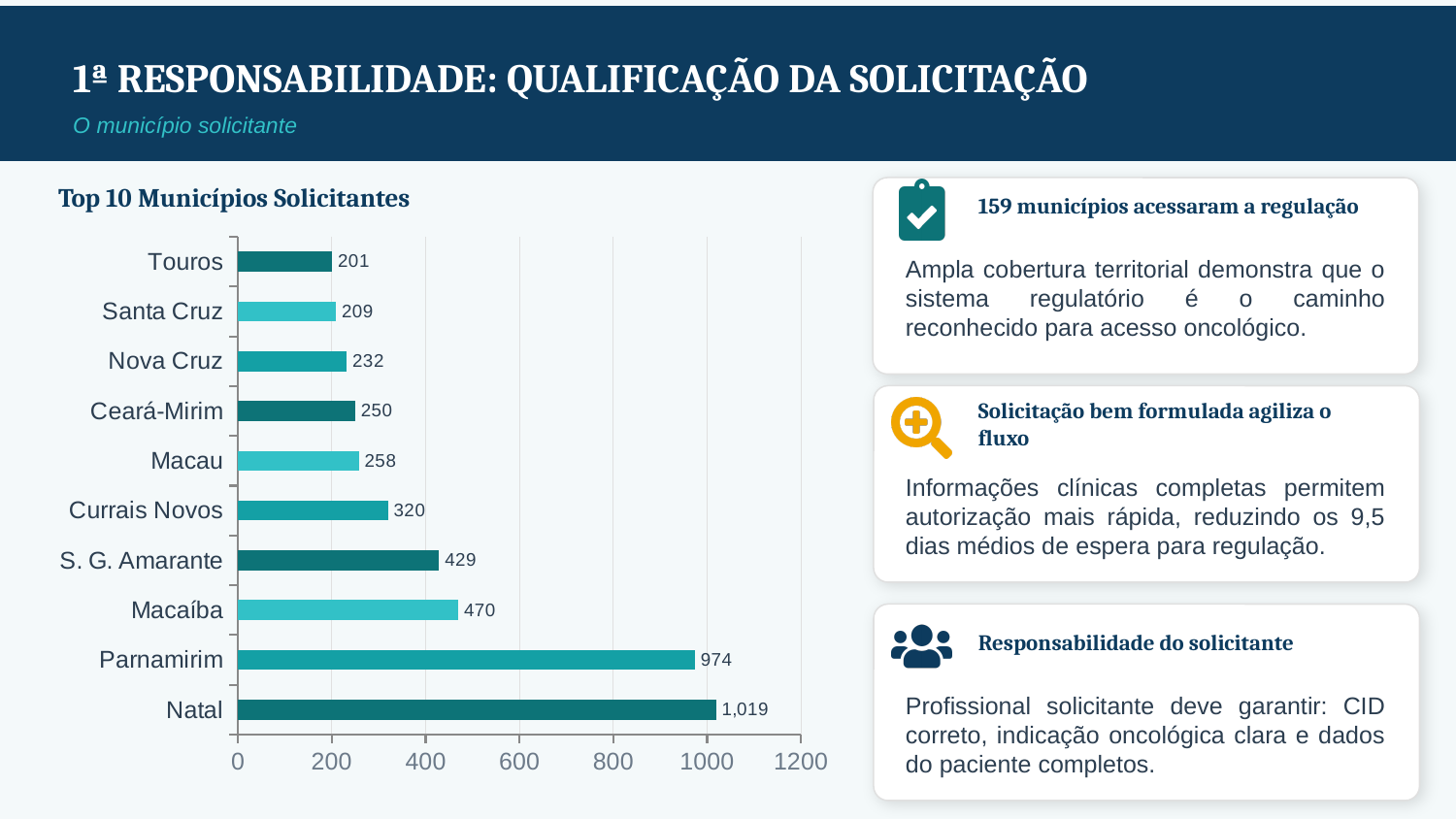
Which has a larger value, Macau or Ceará-Mirim? Macau How many municipalities are shown in the chart? 10 What kind of chart is shown on the slide? bar chart Is the value for Parnamirim greater or less than 1000? less What is the difference between the values for Natal and Parnamirim? 45 What is the value for Parnamirim? 974 What is the title of the chart? Top 10 Municípios Solicitantes What is the value for Currais Novos? 320 Which municipality has the lowest value? Touros What is the value for Natal? 1,019 What is the difference between the values for Macaíba and S. G. Amarante? 41 Which municipality has the highest value? Natal